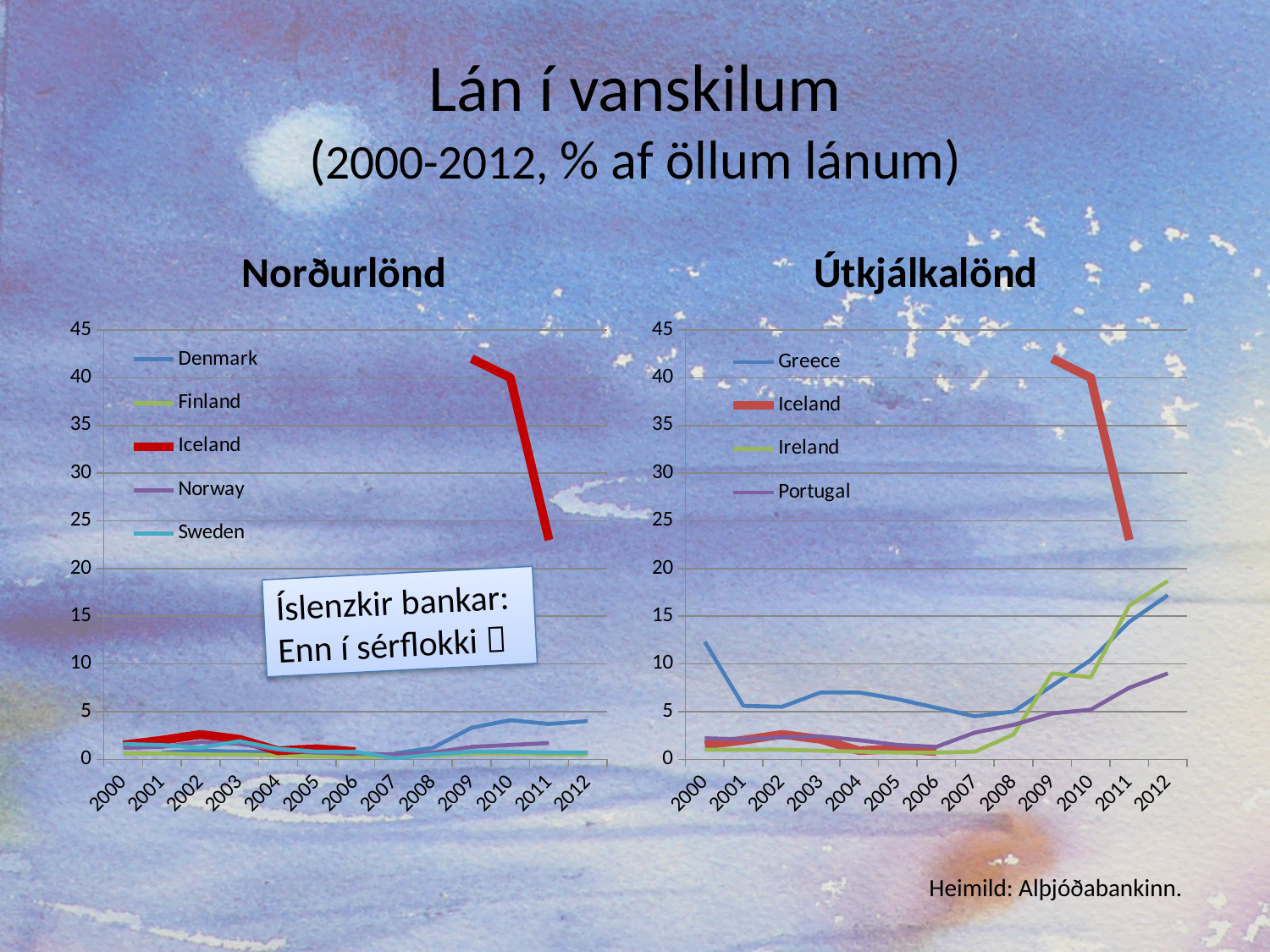
In the Útkjálkalönd chart, is the value for Greece in 2000 greater or less than 10? greater How many years are shown on the x axis of the Útkjálkalönd chart? 13 How many series does the legend of the Útkjálkalönd chart list? 4 Which country appears in the legends of both charts? Iceland In the Norðurlönd chart, is the value for Denmark in 2012 greater or less than 5? less In the Útkjálkalönd chart, which is larger in 2012, Ireland or Portugal? Ireland In the Útkjálkalönd chart, which series has the highest value in 2012? Ireland In the Norðurlönd chart, is the value for Iceland in 2010 greater or less than 35? greater What kind of chart is the Norðurlönd chart on the left? Line chart How many series does the legend of the Norðurlönd chart list? 5 In the Útkjálkalönd chart, does the Ireland line rise or fall from 2007 to 2012? Rise